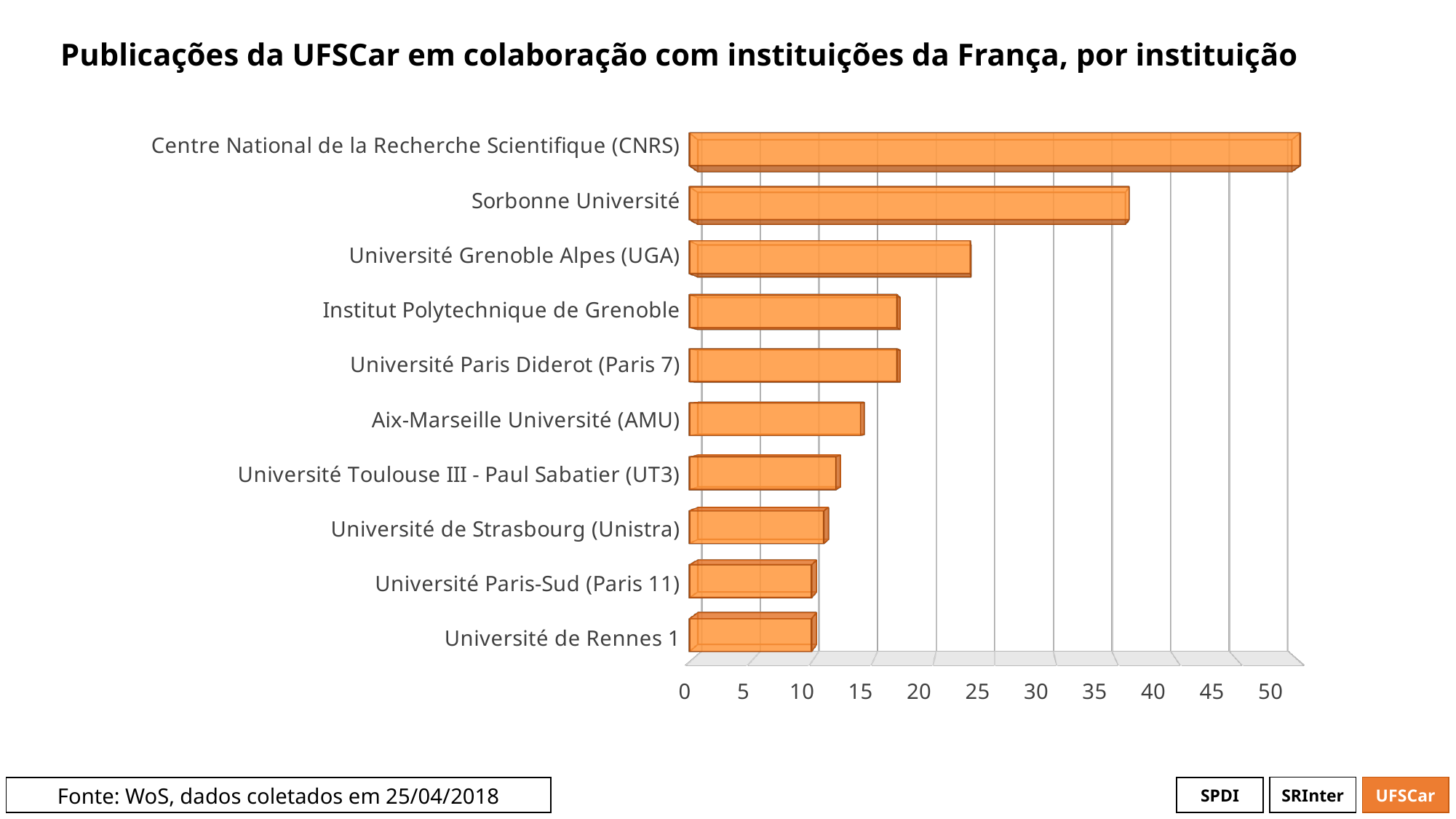
What kind of chart is shown on the slide? bar chart What is the title of the chart? Publicações da UFSCar em colaboração com instituições da França, por instituição Which has more publications, Sorbonne Université or Université Grenoble Alpes (UGA)? Sorbonne Université How many institutions are shown in the chart? 10 Is the value for Université Paris-Sud (Paris 11) greater or less than 15? less Is the value for Université Grenoble Alpes (UGA) greater or less than 20? greater Is the value for Sorbonne Université greater or less than 40? less Which has more publications, Aix-Marseille Université (AMU) or Université de Rennes 1? Aix-Marseille Université (AMU) Which institution has the highest number of publications in collaboration with UFSCar? Centre National de la Recherche Scientifique (CNRS)